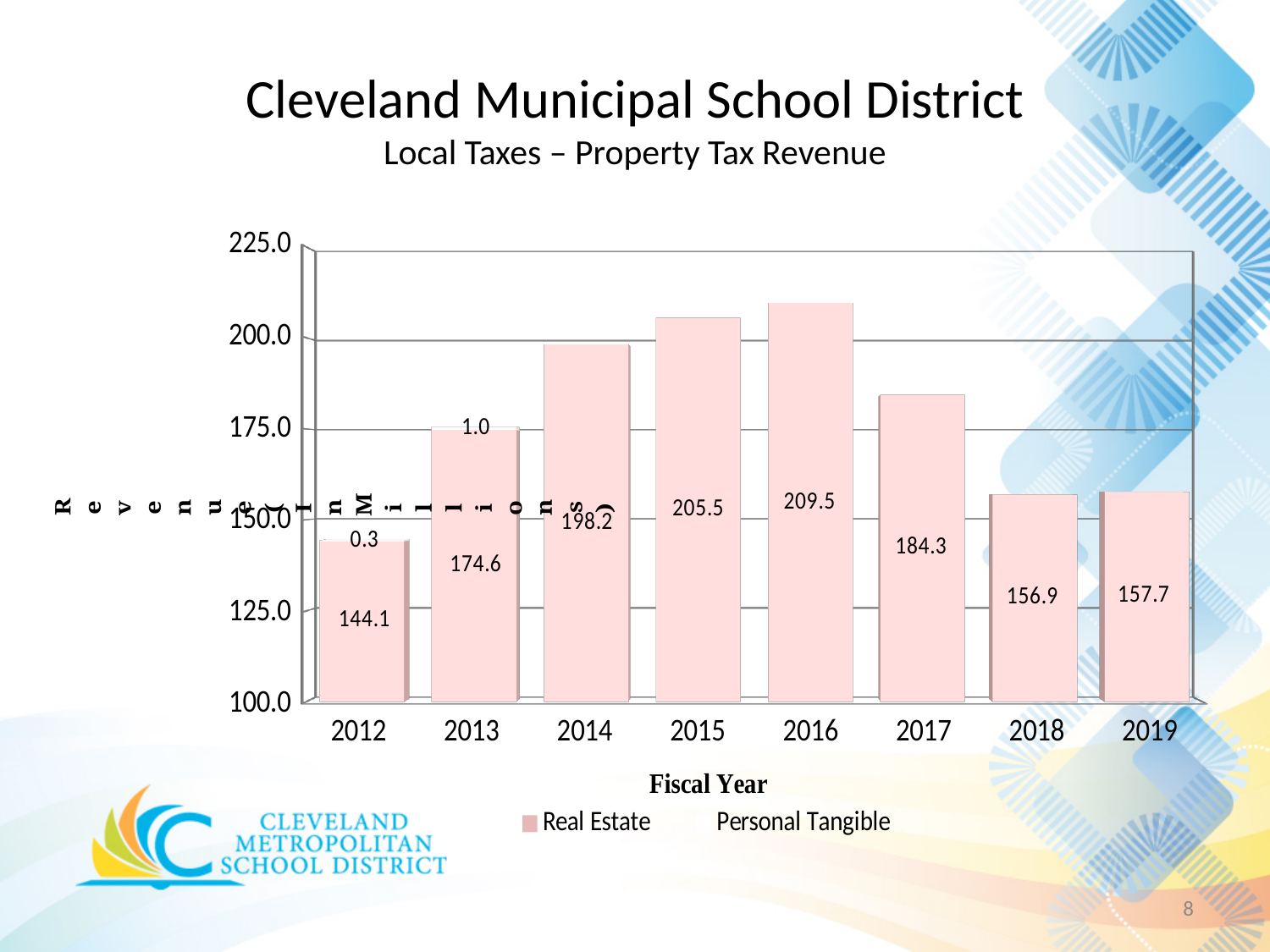
What is the Real Estate value for fiscal year 2012? 144.1 What is the Real Estate value for fiscal year 2016? 209.5 What kind of chart is shown on the slide? bar chart Which is larger, the Real Estate value for 2014 or for 2017? 2014 What is the Personal Tangible value for fiscal year 2013? 1.0 Which fiscal year has the lowest Real Estate value? 2012 How many fiscal years are shown on the x axis? 8 How many series does the legend list? 2 What is the difference between the Real Estate values for 2016 and 2017? 25.2 What is the label of the x axis? Fiscal Year Is the Real Estate value for 2015 greater or less than 200.0? greater Which fiscal year has the highest Real Estate value? 2016